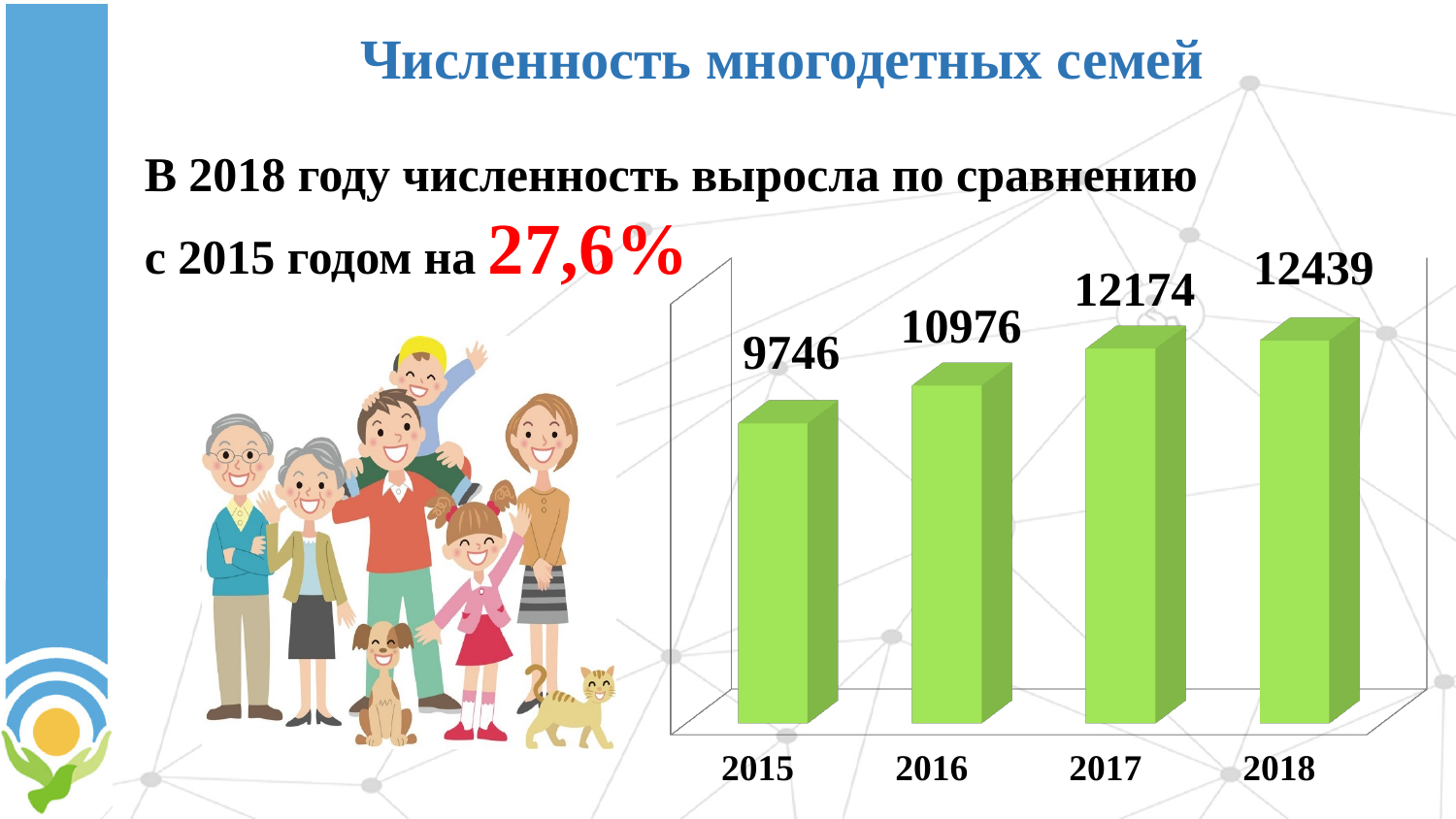
What is the difference between the values for 2016 and 2015? 1230 Which year has the highest value? 2018 What is the value for 2017? 12174 What is the value for 2016? 10976 What is the value for 2018? 12439 What kind of chart is shown on the slide? bar chart What is the difference between the values for 2018 and 2015? 2693 What is the value for 2015? 9746 Which is larger, the value for 2016 or the value for 2017? 2017 Do the values rise or fall from 2015 to 2018? rise How many years are shown on the chart? 4 Which year has the lowest value? 2015